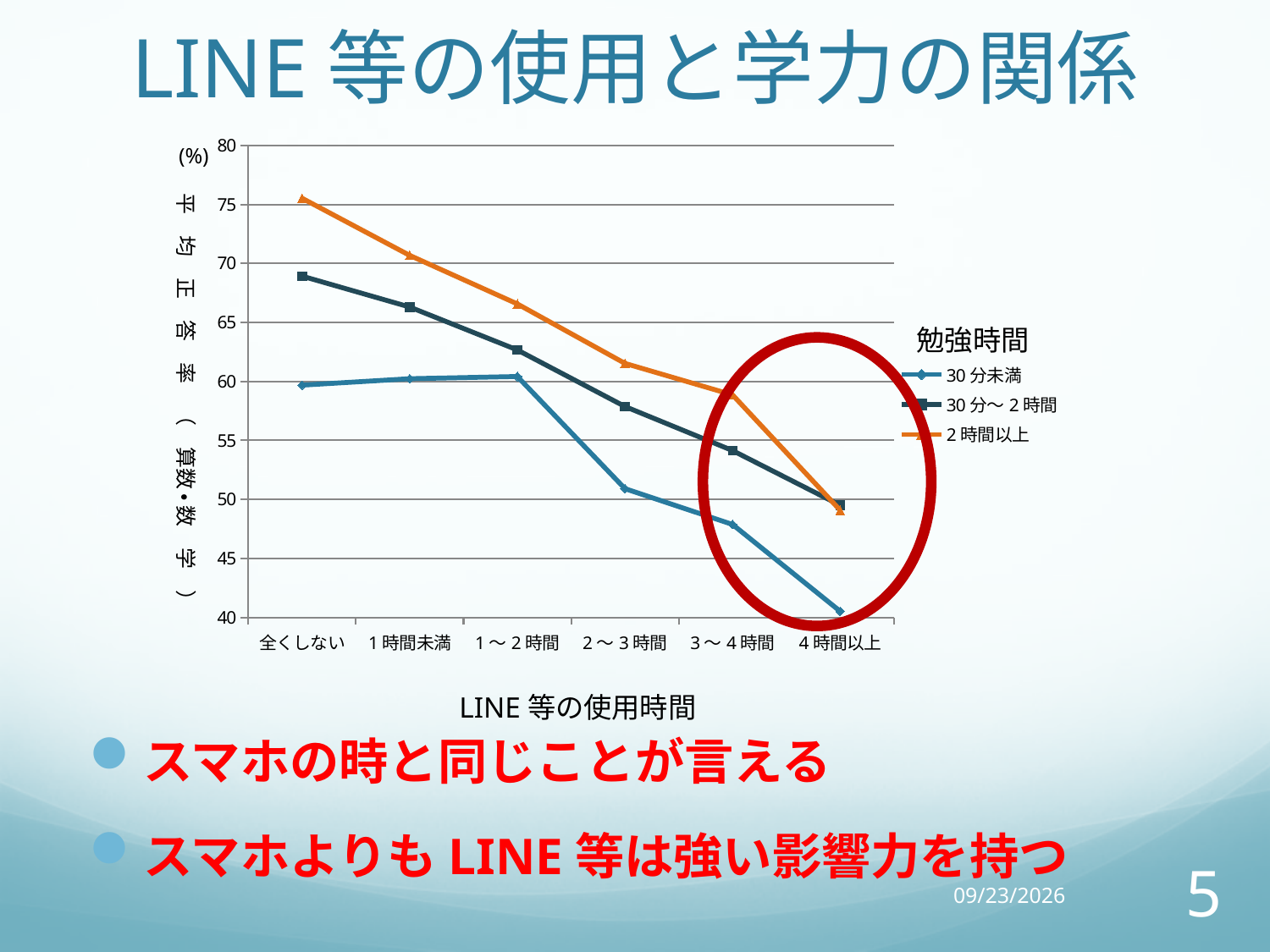
Is the value for 2時間以上 at 全くしない greater or less than 70? greater How many categories are on the x axis? 6 What is the title of the legend? 勉強時間 Does the 2時間以上 series rise or fall from 全くしない to 4時間以上? fall Is the value for 30分～2時間 at 全くしない greater or less than 65? greater At 1～2時間, which is larger: the value for 2時間以上 or the value for 30分未満? 2時間以上 How many series does the legend list? 3 Which series has the lowest value at 4時間以上? 30分未満 What is the x-axis label of the chart? LINE等の使用時間 Which series has the highest value at 全くしない? 2時間以上 Is the value for 30分未満 at 4時間以上 greater or less than 45? less What kind of chart is shown on the slide? line chart